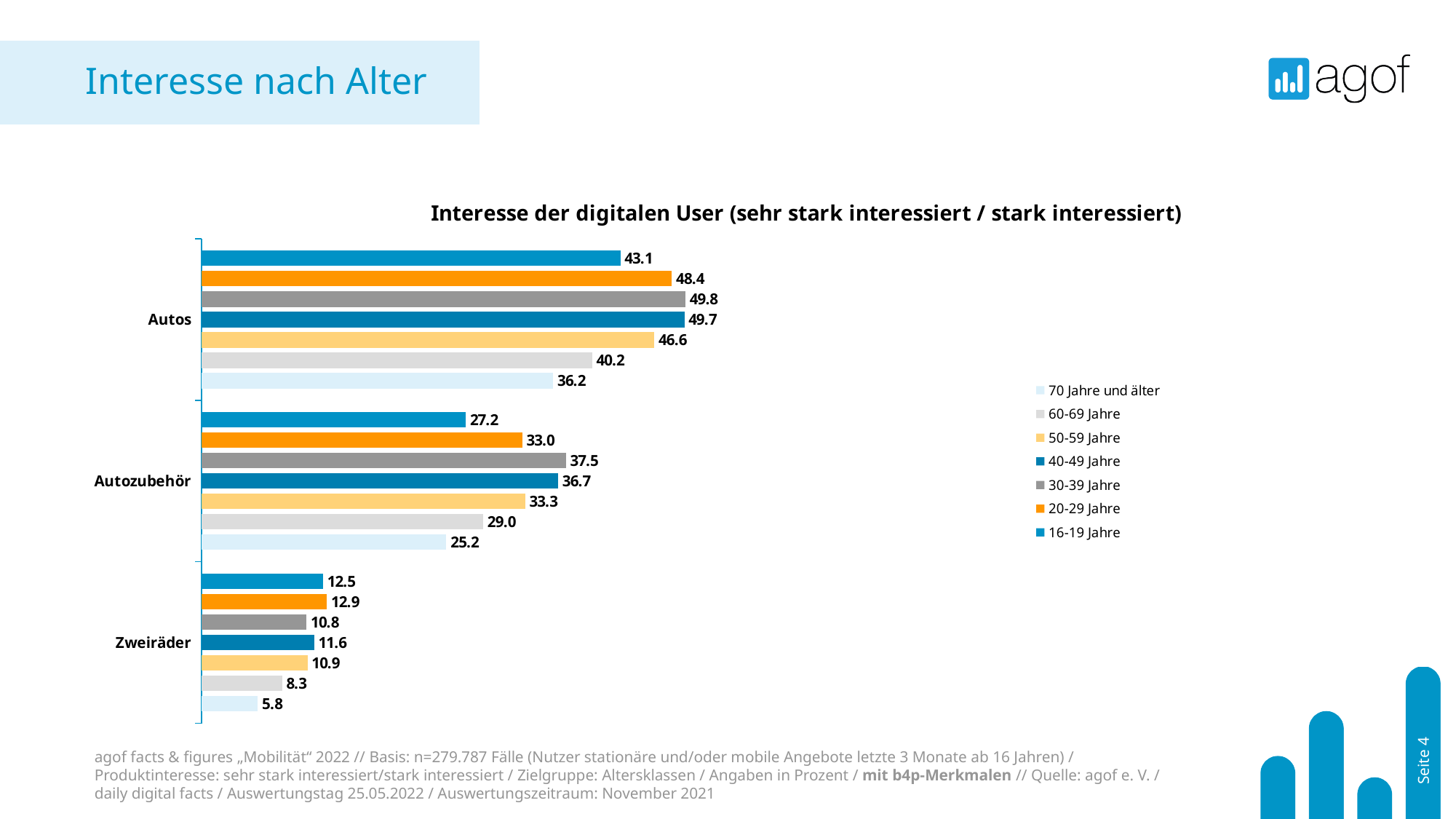
What is the title of the chart? Interesse der digitalen User (sehr stark interessiert / stark interessiert) How many age groups does the legend list? 7 What is the value for Autozubehör among 30-39 Jahre? 37.5 What is the value for Zweiräder among 70 Jahre und älter? 5.8 What is the value for Autos among 16-19 Jahre? 43.1 Which age group has the lowest value for Autos? 70 Jahre und älter How many product categories are shown on the chart? 3 What type of chart is shown? Bar chart Which age group has the highest value for Zweiräder? 20-29 Jahre What is the difference between the 20-29 Jahre and 16-19 Jahre values for Autozubehör? 5.8 Which is larger for Autos: the value for 50-59 Jahre or the value for 60-69 Jahre? 50-59 Jahre What is the value for Autozubehör among 60-69 Jahre? 29.0